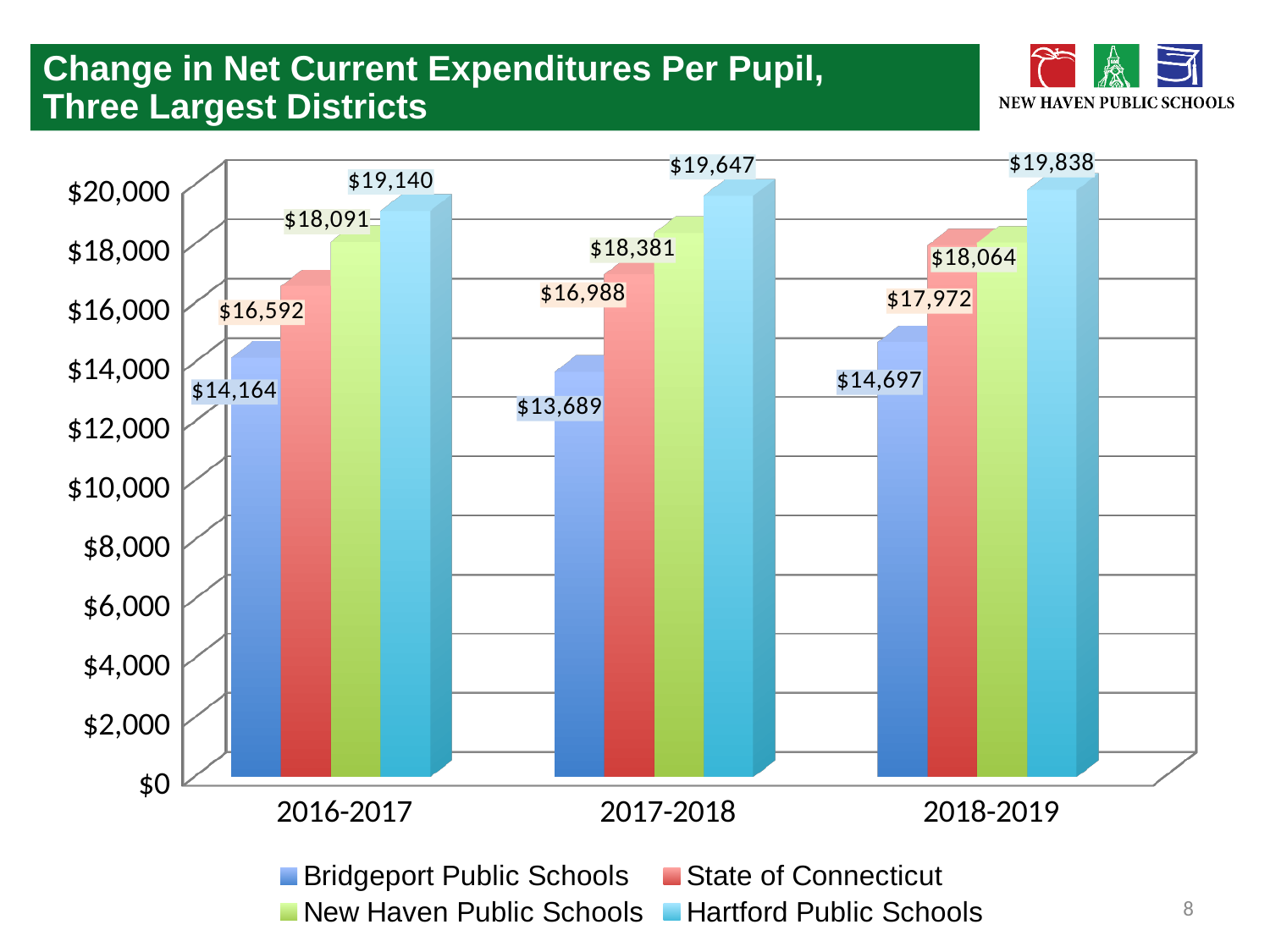
What is the difference between Hartford Public Schools and Bridgeport Public Schools in 2018-2019? $5,141 Which series has the lowest value in 2016-2017? Bridgeport Public Schools How many school years are shown on the x axis? 3 What was the net current expenditure per pupil for Hartford Public Schools in 2018-2019? $19,838 What was the net current expenditure per pupil for Bridgeport Public Schools in 2017-2018? $13,689 Which series has the highest value in 2017-2018? Hartford Public Schools Which is larger: New Haven Public Schools in 2017-2018 or State of Connecticut in 2018-2019? New Haven Public Schools in 2017-2018 What was the value for New Haven Public Schools in 2018-2019? $18,064 How many series does the legend list? 4 By how much did the Hartford Public Schools value increase from 2016-2017 to 2018-2019? $698 What was the State of Connecticut value in 2016-2017? $16,592 Do the values for Hartford Public Schools rise or fall from 2016-2017 to 2018-2019? rise